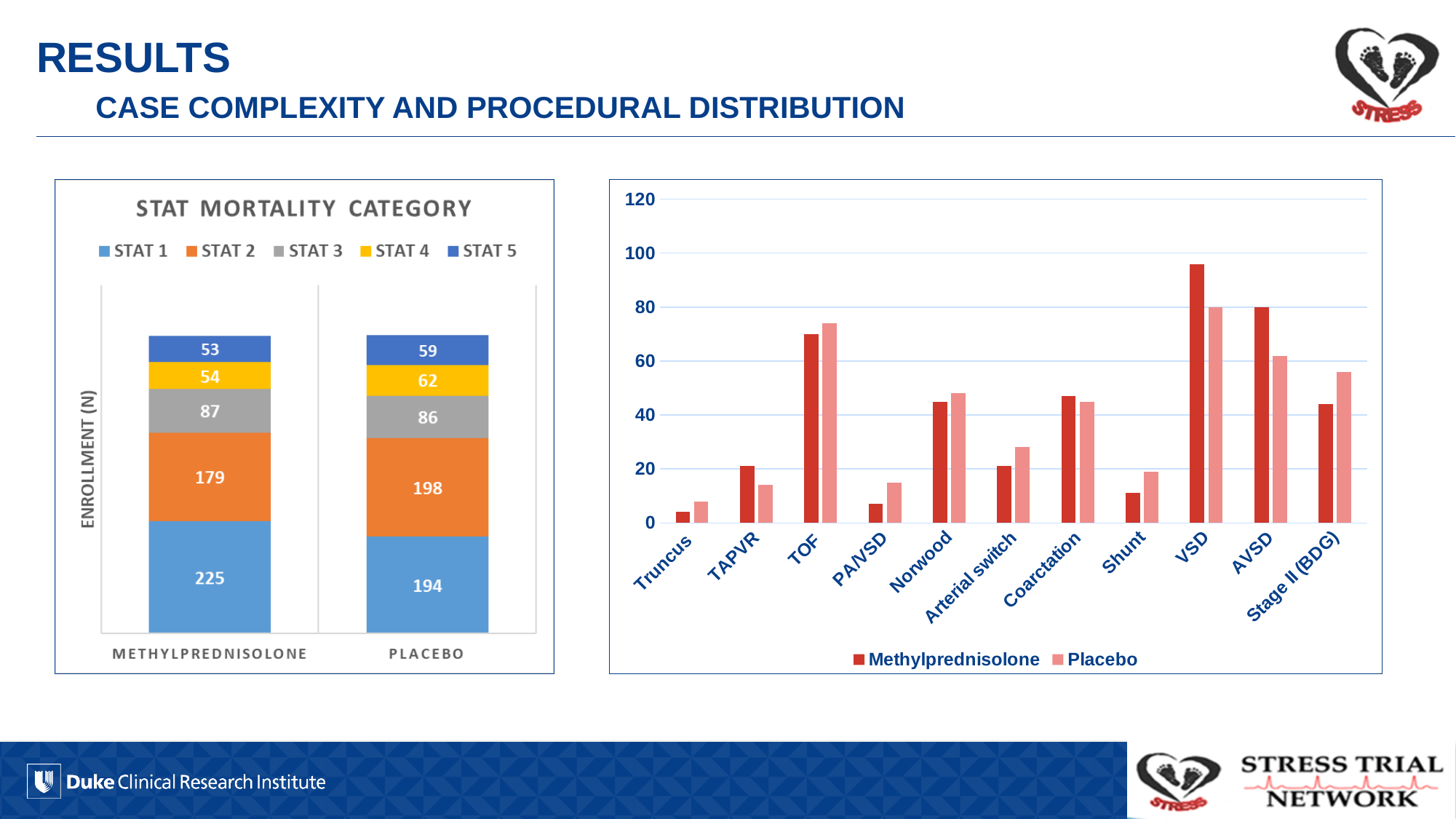
In the chart on the right, how many procedure categories are shown on the x axis? 11 How many series does the legend of the STAT MORTALITY CATEGORY chart list? 5 In the STAT MORTALITY CATEGORY chart, which is larger: STAT 5 for Methylprednisolone or STAT 5 for Placebo? Placebo In the STAT MORTALITY CATEGORY chart, what is the total enrollment for the Placebo bar? 599 What kind of chart is the STAT MORTALITY CATEGORY chart? Stacked bar chart In the chart on the right, is the Methylprednisolone value for Truncus greater or less than 20? less In the STAT MORTALITY CATEGORY chart, what is the STAT 4 value for Methylprednisolone? 54 In the STAT MORTALITY CATEGORY chart, what is the difference between the STAT 1 values for Methylprednisolone and Placebo? 31 In the chart on the right, which procedure has the highest Methylprednisolone bar? VSD In the STAT MORTALITY CATEGORY chart, what is the STAT 2 value for Placebo? 198 In the chart on the right, is the Methylprednisolone value for VSD greater or less than 80? greater In the STAT MORTALITY CATEGORY chart, what is the STAT 1 value for Methylprednisolone? 225